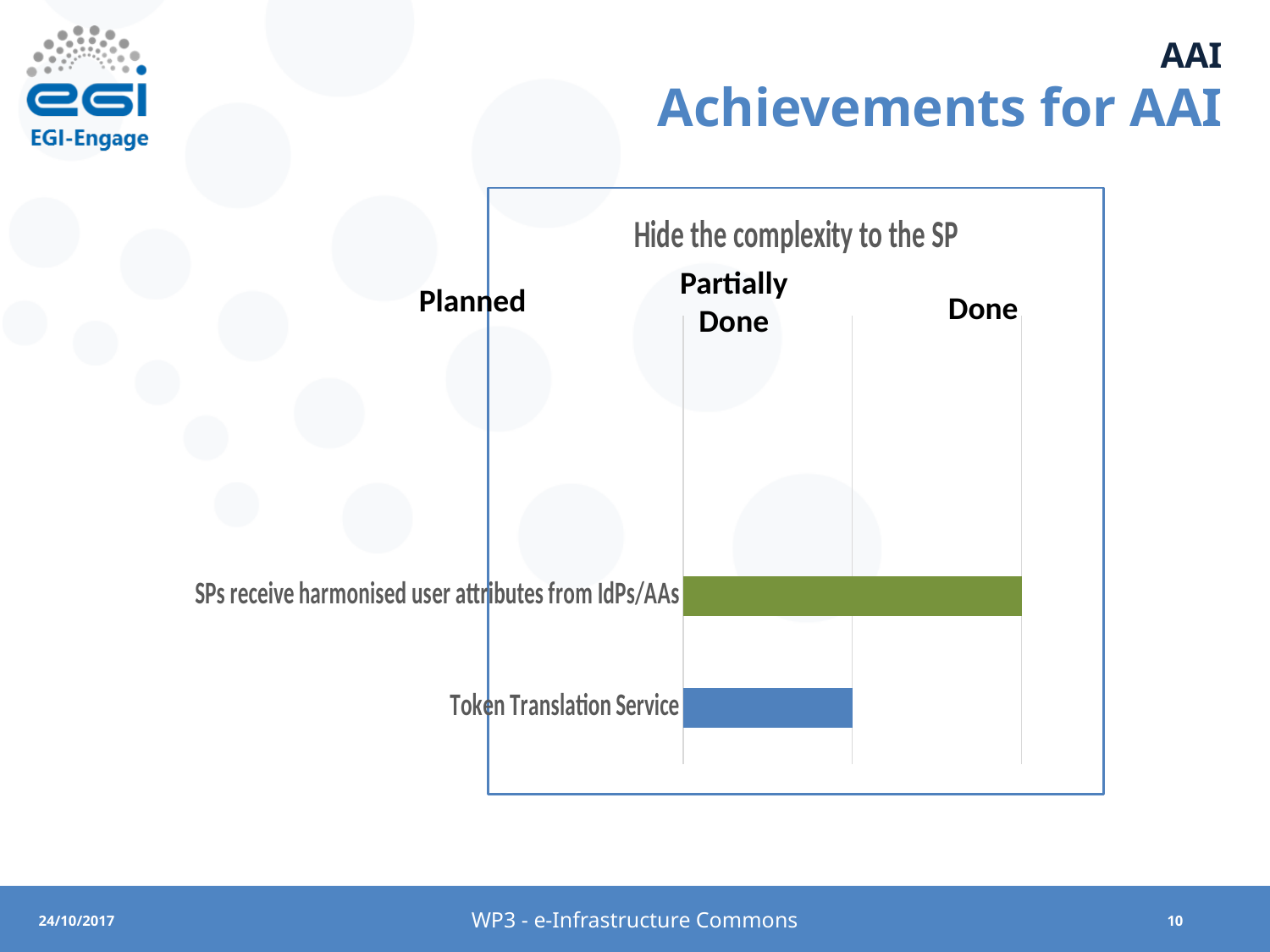
Which status does the bar for 'Token Translation Service' reach on the axis? Partially Done Which category has the longest bar? SPs receive harmonised user attributes from IdPs/AAs What is the title of the chart? Hide the complexity to the SP Which bar is longer: 'Token Translation Service' or 'SPs receive harmonised user attributes from IdPs/AAs'? SPs receive harmonised user attributes from IdPs/AAs Has the 'Token Translation Service' bar reached the 'Done' mark on the axis? No How many categories are plotted in the chart? 2 What kind of chart is shown on the slide? bar chart What are the three status labels shown along the axis of the chart? Planned, Partially Done, Done Which category has the shortest bar? Token Translation Service Which status does the bar for 'SPs receive harmonised user attributes from IdPs/AAs' reach on the axis? Done